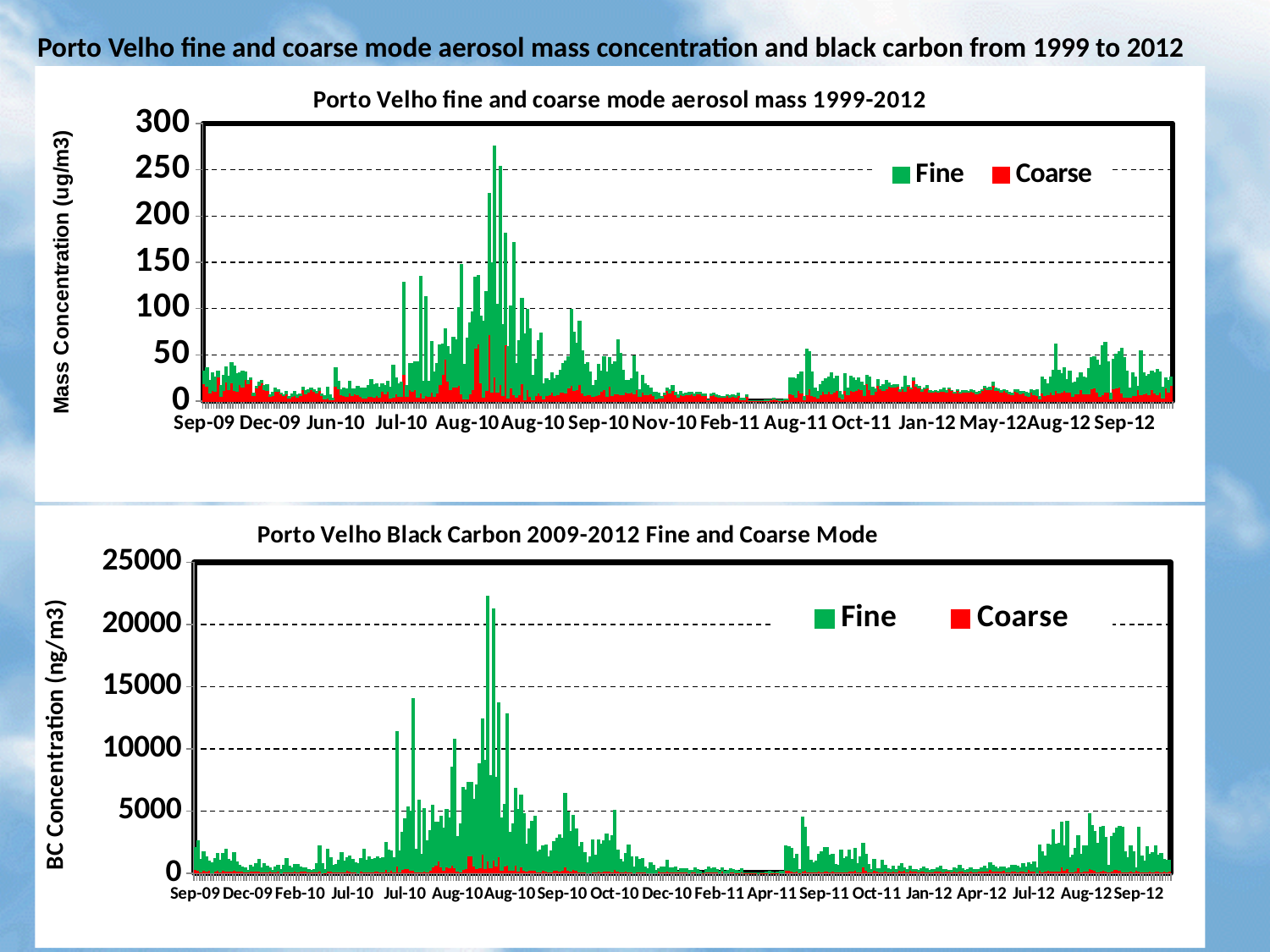
In the top chart, is the highest Coarse value greater or less than 100? less How many series does the legend of the bottom chart, 'Porto Velho Black Carbon 2009-2012 Fine and Coarse Mode', list? 2 What is the y-axis label of the bottom chart? BC Concentration (ng/m3) In the top chart, which series reaches the higher peak, Fine or Coarse? Fine In the top chart, do the Fine values generally rise or fall between Aug-10 and Feb-11? fall In the bottom chart, is the highest Fine value greater or less than 20000? greater What kind of chart is the top chart, 'Porto Velho fine and coarse mode aerosol mass 1999-2012'? Bar chart In the bottom chart, is the highest Coarse value greater or less than 5000? less What colour represents the Coarse series in the top chart? Red In the bottom chart, which series reaches the higher peak, Fine or Coarse? Fine In the bottom chart, do the Fine values generally rise or fall between Jul-10 and Aug-10? rise